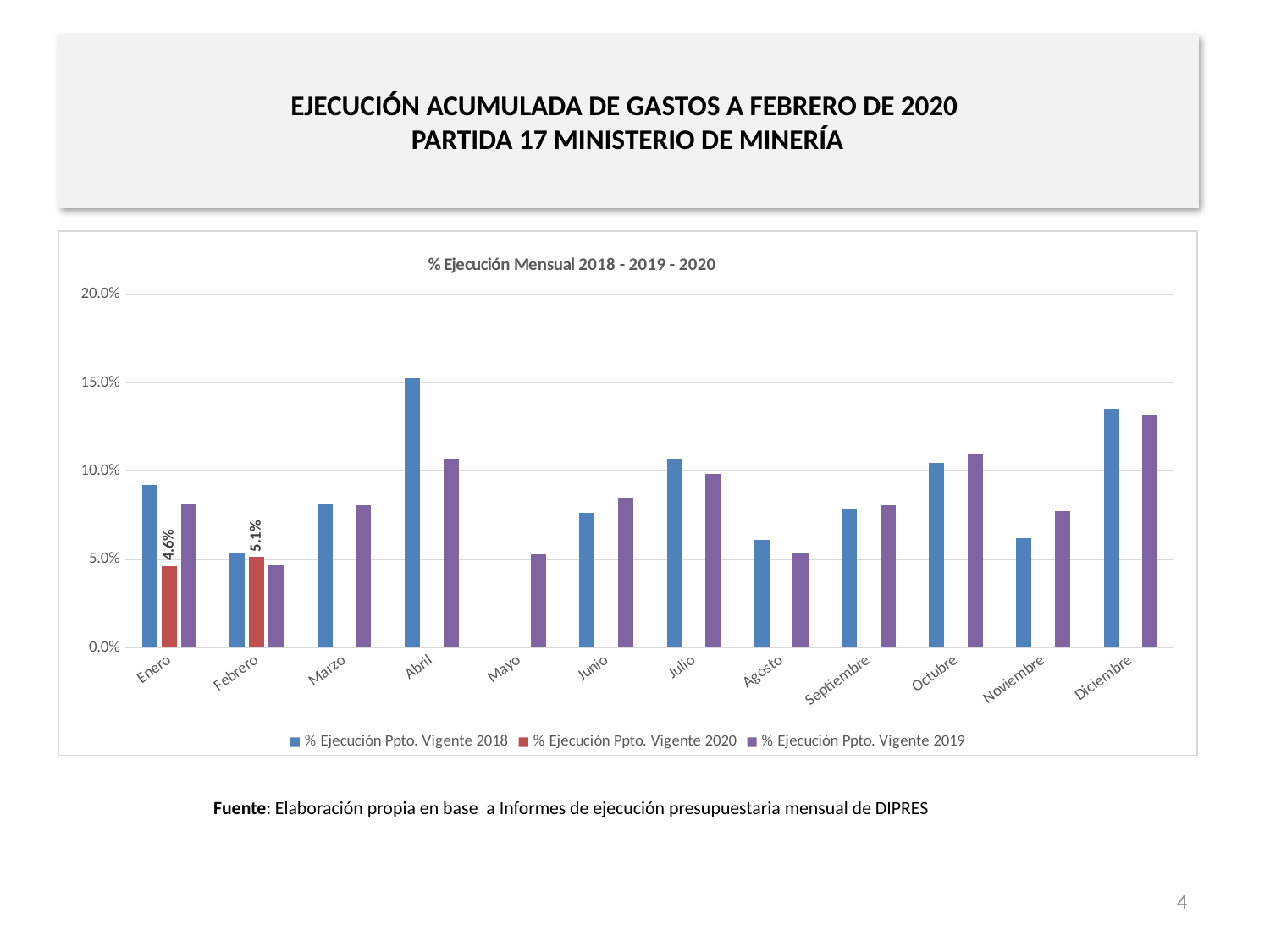
How many series does the chart legend list? 3 Is the value for Abril in the % Ejecución Ppto. Vigente 2018 series greater or less than 10.0%? greater What type of chart is shown on the slide? Bar chart Is the value for Mayo in the % Ejecución Ppto. Vigente 2019 series greater or less than 10.0%? less Which month has the highest value in the % Ejecución Ppto. Vigente 2018 series? Abril What is the value for Febrero in the % Ejecución Ppto. Vigente 2020 series? 5.1% What is the value for Enero in the % Ejecución Ppto. Vigente 2020 series? 4.6% In the % Ejecución Ppto. Vigente 2020 series, which month has the larger value, Enero or Febrero? Febrero For Julio, which series has the larger value, % Ejecución Ppto. Vigente 2018 or % Ejecución Ppto. Vigente 2019? % Ejecución Ppto. Vigente 2018 Which month has the lowest value in the % Ejecución Ppto. Vigente 2019 series? Febrero How many months are shown on the x axis of the chart? 12 What is the difference between the Febrero and Enero values of the % Ejecución Ppto. Vigente 2020 series? 0.5%